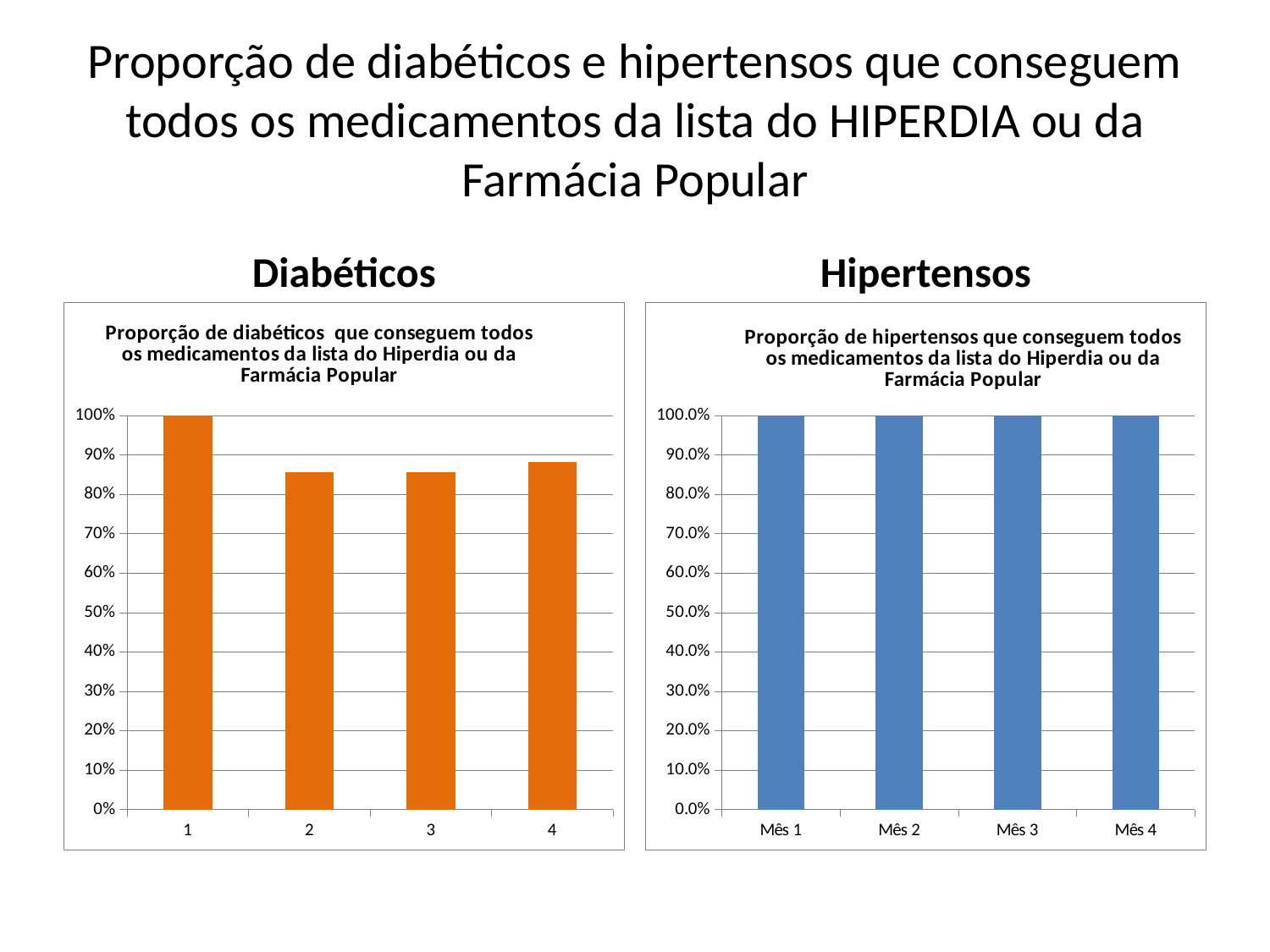
In the Diabéticos chart, which is larger, the value for category 1 or category 2? 1 In the Diabéticos chart, is the value for category 4 greater or less than 90%? less How many categories are shown in the Diabéticos chart? 4 In the Hipertensos chart, what is the value for Mês 4? 100.0% In the Diabéticos chart, is the value for category 3 greater or less than 90%? less In the Diabéticos chart, which category has the highest value? 1 What kind of chart is the Hipertensos chart? bar chart In the Diabéticos chart, is the value for category 2 greater or less than 80%? greater In the Hipertensos chart, what is the value for Mês 1? 100.0% What colour are the bars in the Diabéticos chart? orange In the Diabéticos chart, what is the value for category 1? 100% How many bars are in the Hipertensos chart? 4